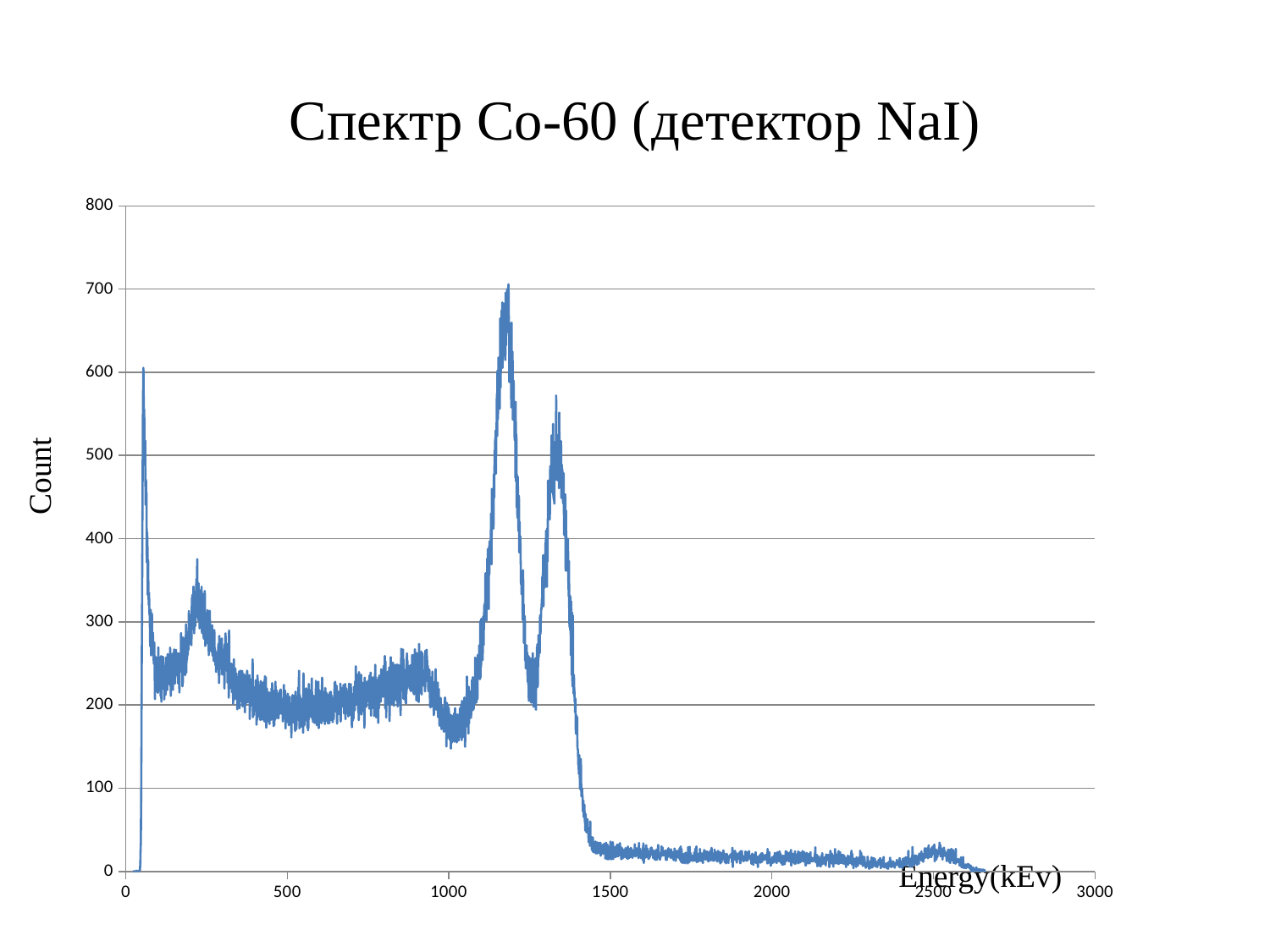
How many data series are plotted on the chart? 1 Is the count at an energy of 2000 keV greater or less than 100? less Is the count at an energy of 500 keV greater or less than 300? less What is the title of the chart? Спектр Co-60 (детектор NaI) What kind of chart is shown on the slide? line chart Is the count at an energy of 1000 keV greater or less than 100? greater What is the label of the vertical axis? Count Do the counts rise or fall along the x axis between 1400 keV and 1500 keV? fall What is the maximum value shown on the vertical axis? 800 Which of the two main peaks is higher: the one near 1200 keV or the one near 1330 keV? the one near 1200 keV